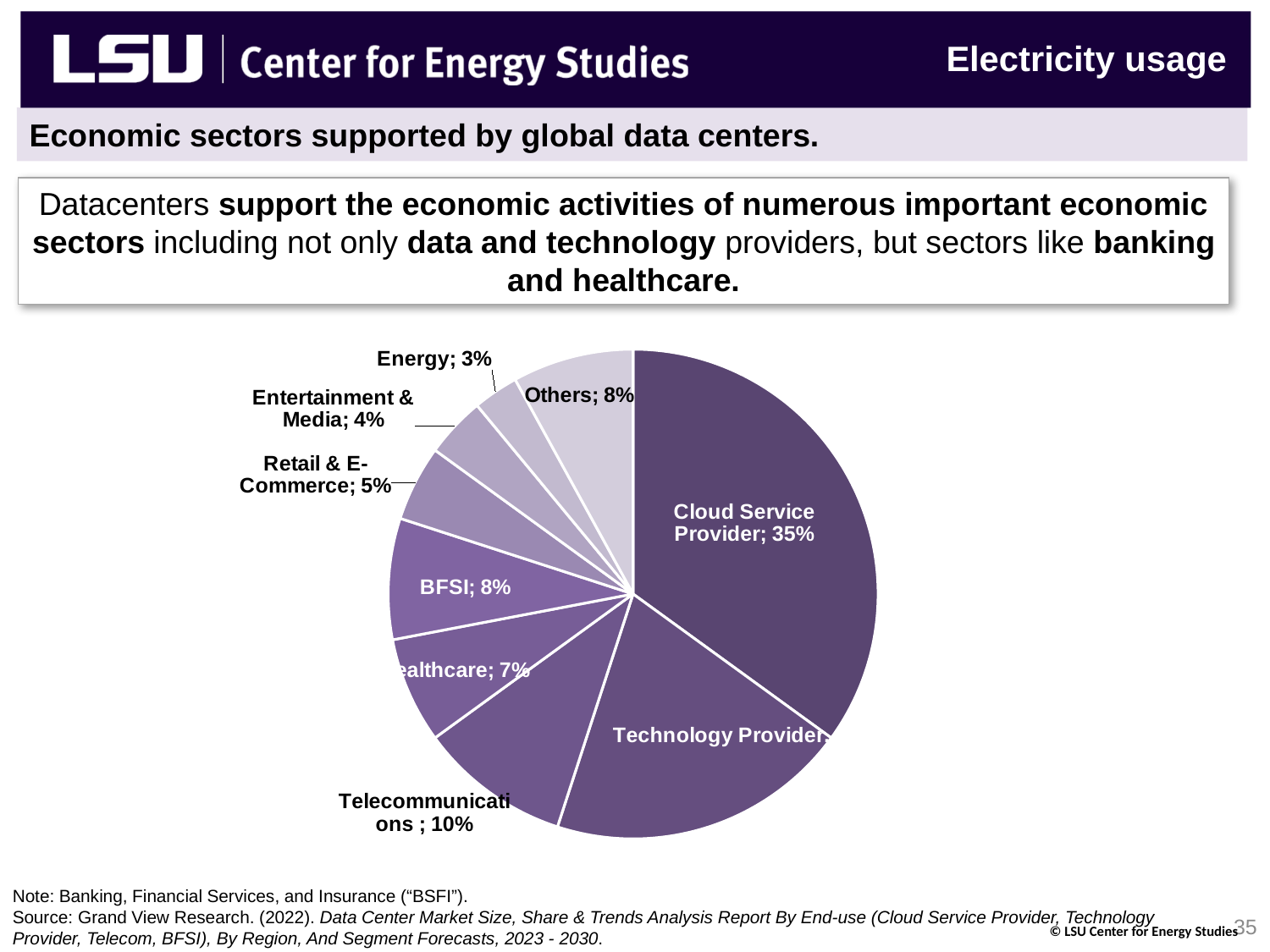
Which sector has the smallest slice of the pie? Energy What is the value shown for Telecommunications? 10% How many sectors (slices) are shown in the pie chart? 9 What type of chart is shown on the slide? Pie chart What is the value shown for Retail & E-Commerce? 5% Which is larger, the BFSI slice or the Healthcare slice? BFSI What share of the pie does Cloud Service Provider account for? 35% Which is larger, the Cloud Service Provider slice or the Technology Provider slice? Cloud Service Provider How many percentage points larger is Cloud Service Provider than Telecommunications? 25 percentage points Which sector has the largest slice of the pie? Cloud Service Provider What is the value shown for Energy? 3% What percentage is shown for BFSI? 8%